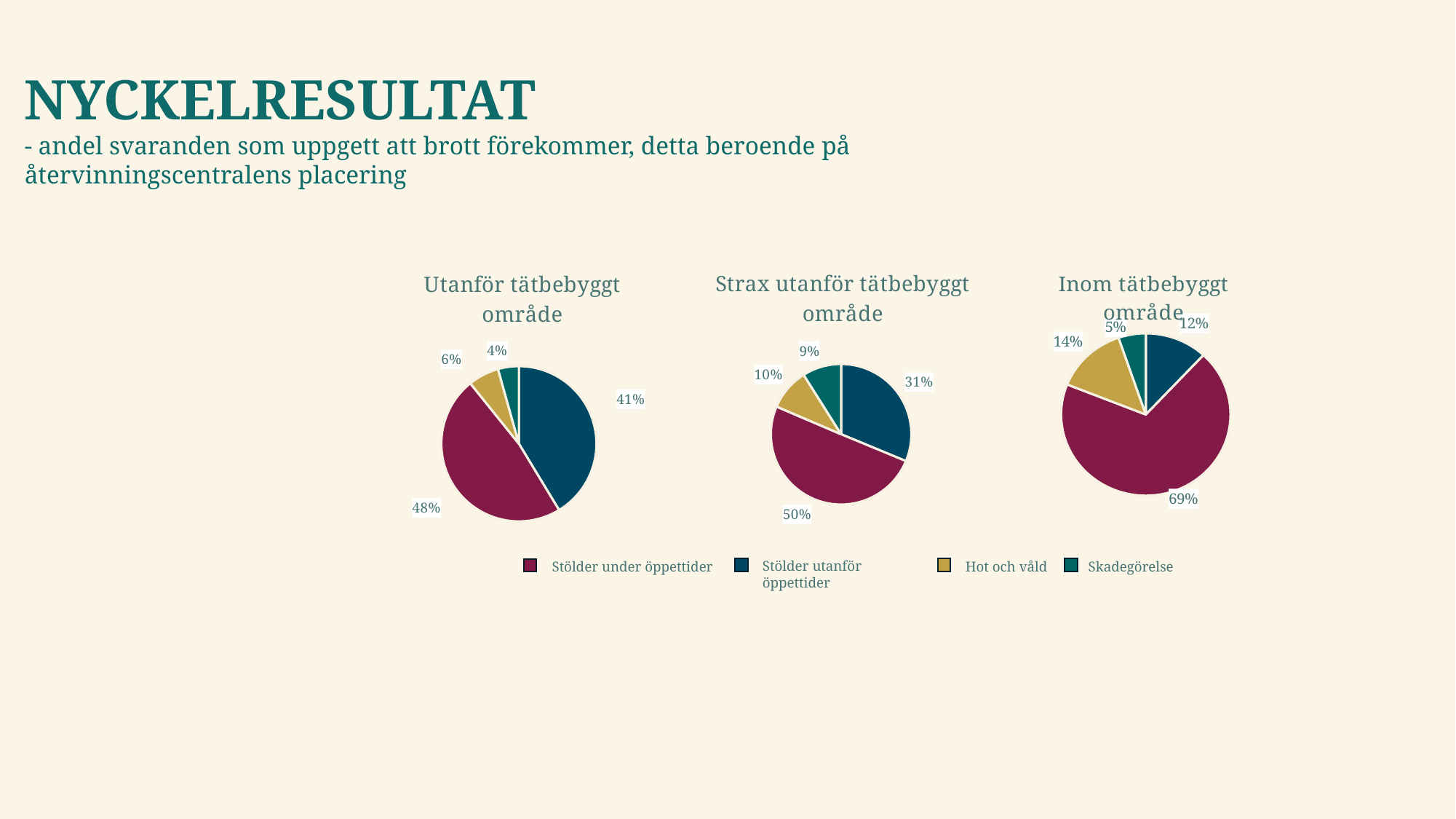
How many slices does the pie chart titled "Strax utanför tätbebyggt område" have? 4 How many entries does the shared legend below the pie charts list? 4 In the pie chart titled "Utanför tätbebyggt område", which category has the smallest slice? Skadegörelse In the pie chart titled "Utanför tätbebyggt område", what share is shown for Stölder under öppettider? 48% In the pie chart titled "Inom tätbebyggt område", what share is shown for Skadegörelse? 5% Which legend entry is shown in gold/yellow? Hot och våld What kind of chart is used for "Inom tätbebyggt område"? Pie chart In the pie chart titled "Strax utanför tätbebyggt område", what share is shown for Hot och våld? 10% In the pie chart titled "Inom tätbebyggt område", which is larger: the share for Hot och våld or the share for Stölder utanför öppettider? Hot och våld In the pie chart titled "Inom tätbebyggt område", which category has the largest slice? Stölder under öppettider In the pie chart titled "Strax utanför tätbebyggt område", what is the difference between the shares for Stölder under öppettider and Stölder utanför öppettider? 19 percentage points In the pie chart titled "Utanför tätbebyggt område", what share is shown for Stölder utanför öppettider? 41%